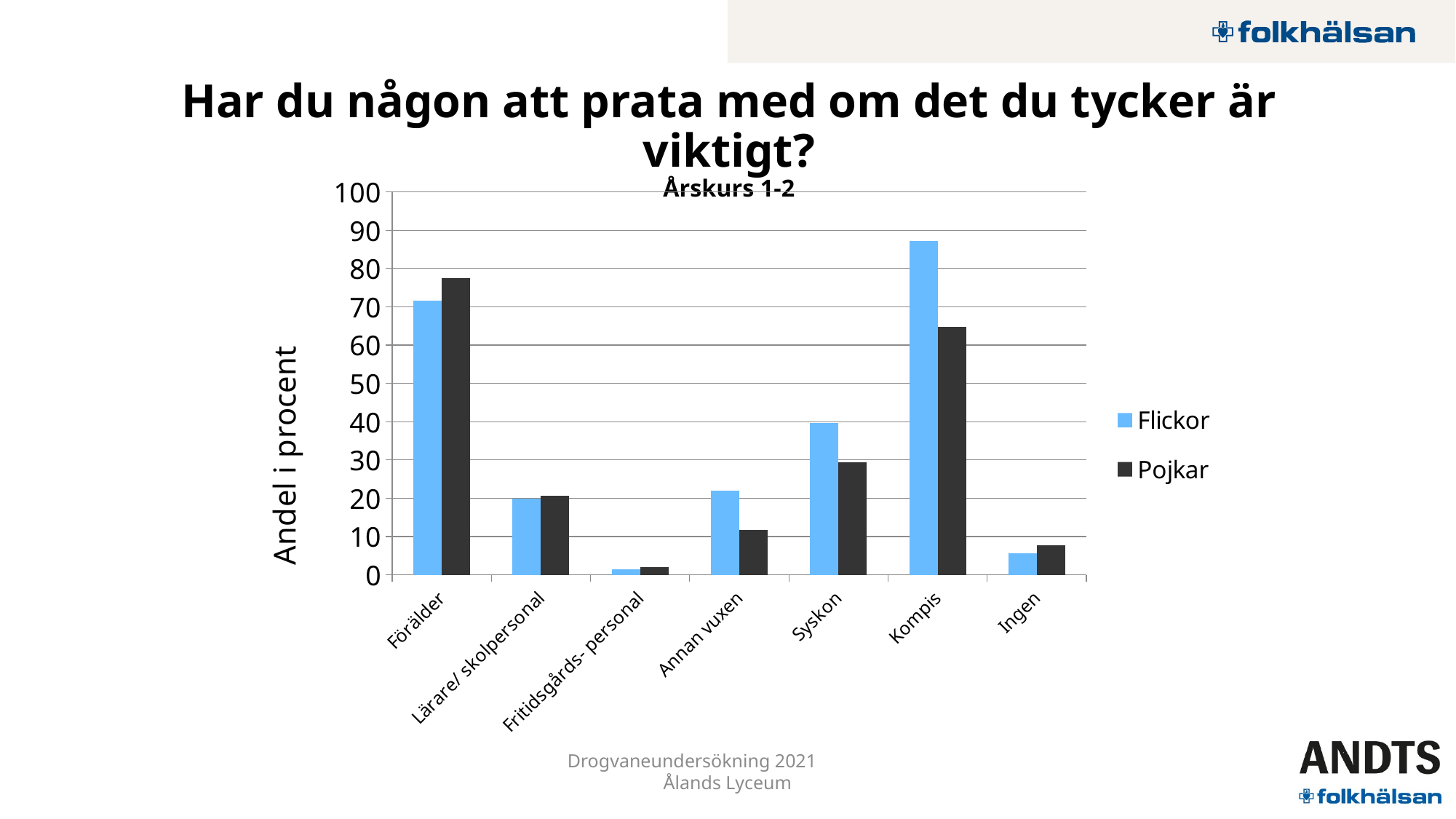
How many series does the legend list? 2 What is the label of the y axis? Andel i procent Is the value for Flickor in the Förälder category greater or less than 70? greater How many categories are shown on the x axis? 7 For the Förälder category, which series has the larger value, Flickor or Pojkar? Pojkar For the Annan vuxen category, which series has the larger value, Flickor or Pojkar? Flickor Which category has the lowest value for Flickor? Fritidsgårds- personal Which category has the highest value for Flickor? Kompis Which category has the highest value for Pojkar? Förälder Is the value for Flickor in the Kompis category greater or less than 80? greater What kind of chart is shown on the slide? bar chart